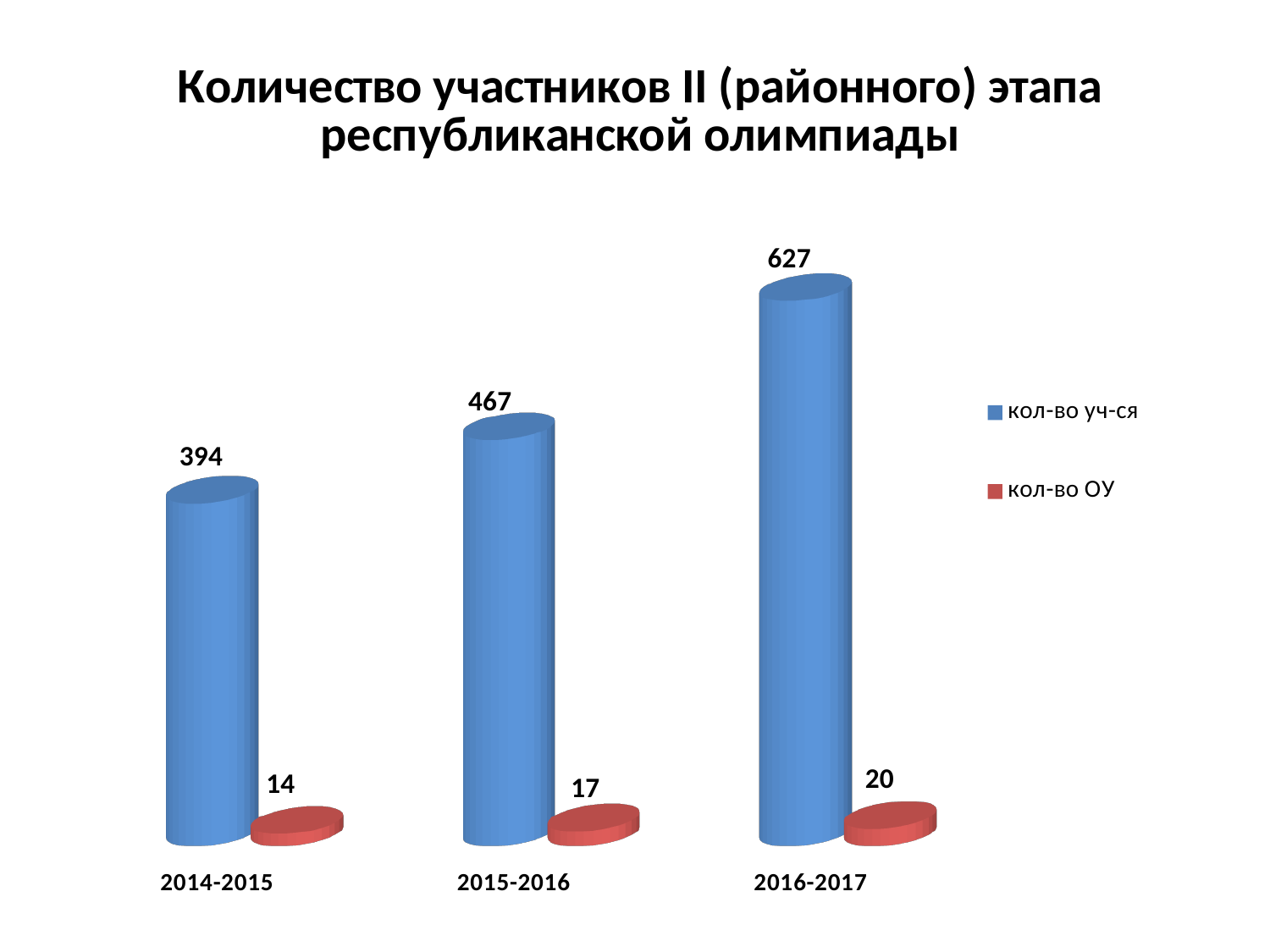
How many year categories are shown on the x axis? 3 What is the value of кол-во ОУ for 2016-2017? 20 What is the value of кол-во уч-ся for 2014-2015? 394 What is the difference between кол-во ОУ in 2016-2017 and 2014-2015? 6 What kind of chart is shown on the slide? bar chart Do the values for кол-во уч-ся rise or fall from 2014-2015 to 2016-2017? rise What is the difference between кол-во уч-ся in 2016-2017 and 2015-2016? 160 Which year has the lowest value for кол-во ОУ? 2014-2015 What is the value of кол-во уч-ся for 2015-2016? 467 Which is larger: кол-во уч-ся in 2014-2015 or in 2015-2016? 2015-2016 Which year has the highest value for кол-во уч-ся? 2016-2017 How many series does the legend list? 2